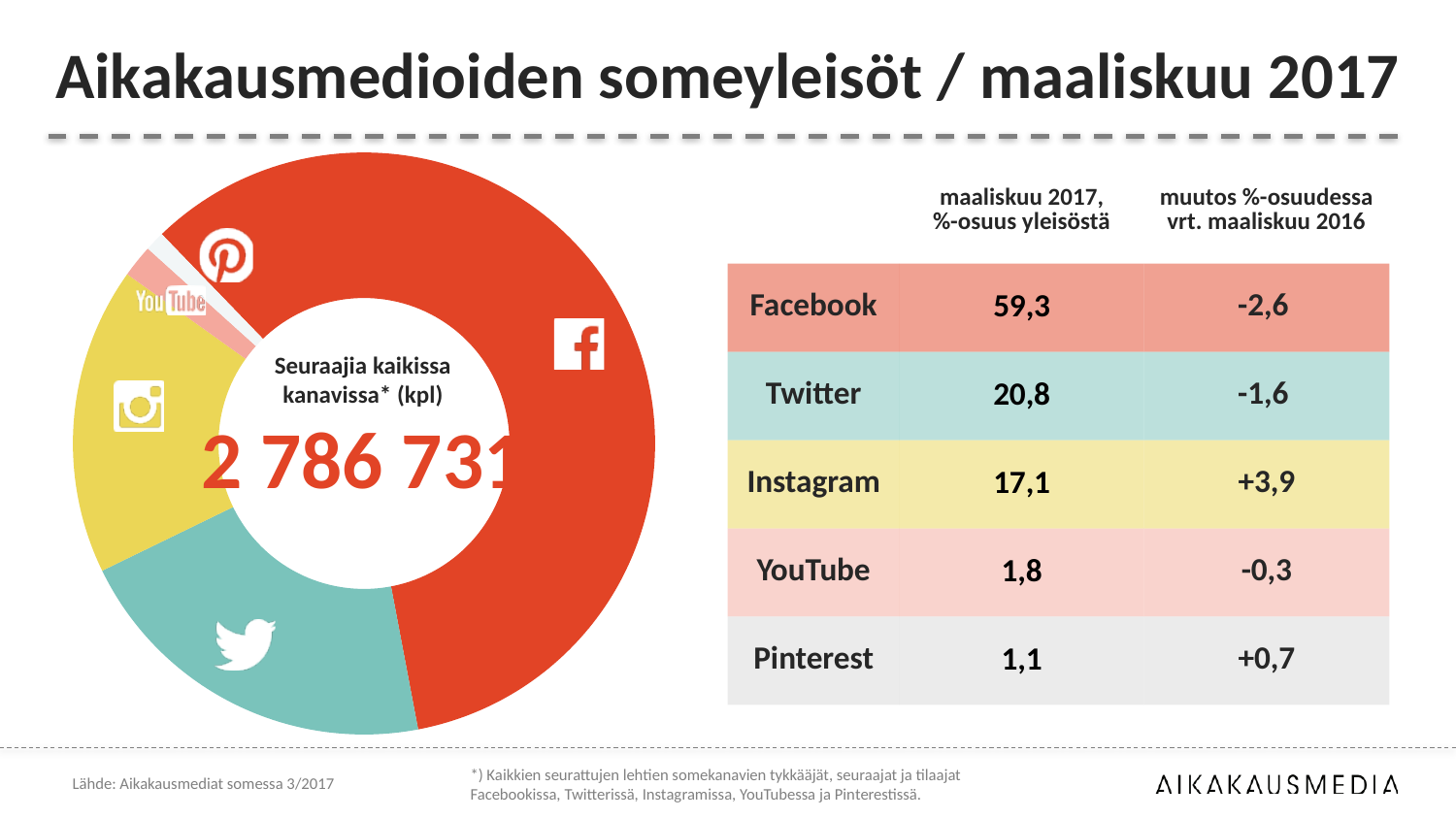
What share of the audience does Instagram have in March 2017? 17,1 Which channel had the largest positive change in percentage share compared to March 2016? Instagram How many social media channels are shown as slices in the donut chart? 5 What is the change in percentage share for Instagram compared to March 2016? +3,9 Which has a larger share of the audience, Twitter or Instagram? Twitter What is the difference in percentage share between Facebook and Twitter in March 2017? 38,5 What is the change in percentage share for Facebook compared to March 2016? -2,6 What kind of chart is shown on the left of the slide? Pie chart (donut) Which channel has the smallest slice in the donut chart? Pinterest What share of the audience does Twitter have in March 2017? 20,8 What share of the audience does Facebook have in March 2017? 59,3 Which channel has the largest slice in the donut chart? Facebook